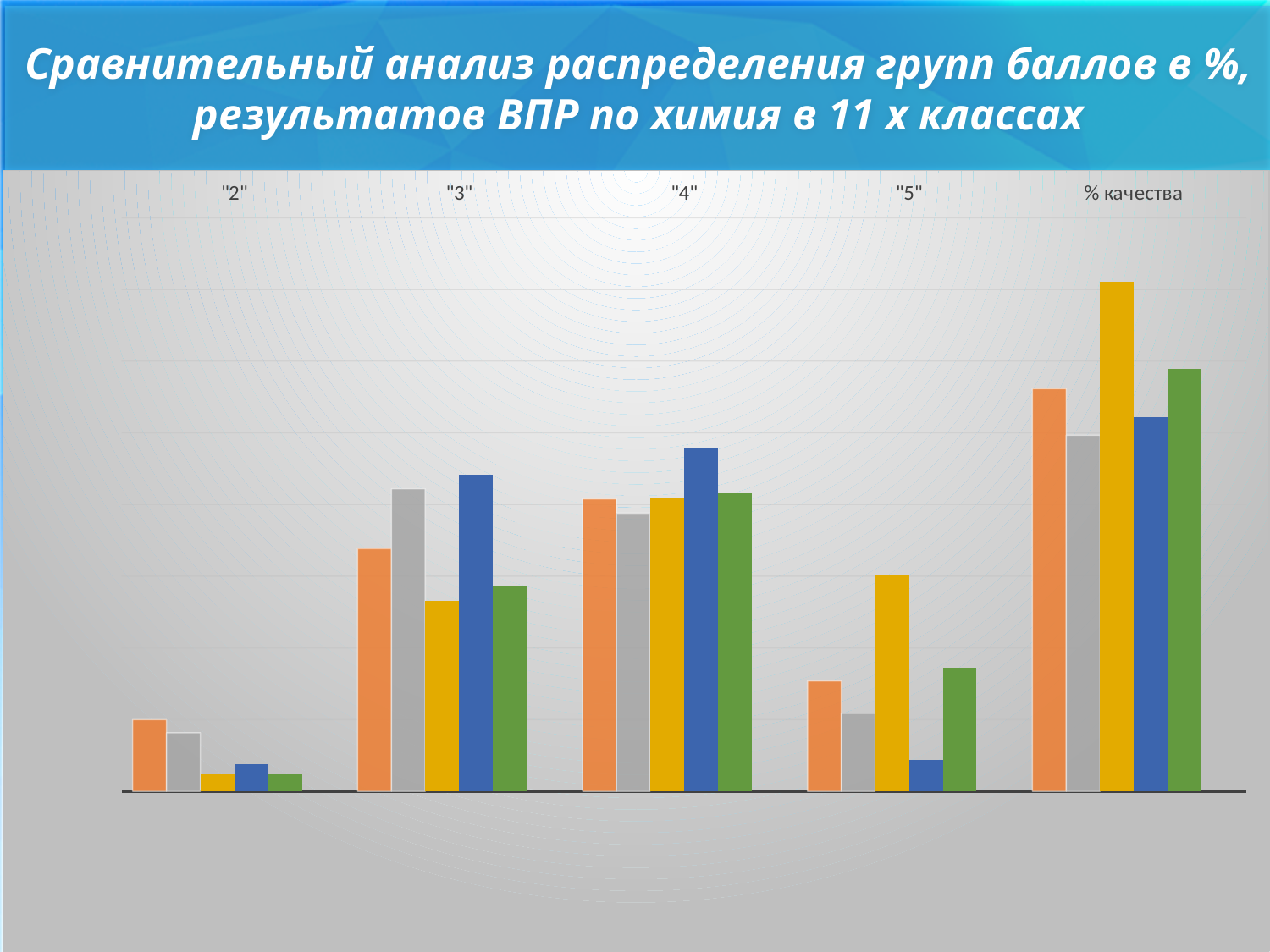
What is the label of the first category on the x axis? "2" What is the label of the last category on the x axis? % качества How many bars are plotted for each category on the chart? 5 Which category has taller bars overall: "3" or "2"? "3" What kind of chart is shown on the slide? bar chart Are the bars for category "4" taller or shorter than the bars for category "2"? taller Which category on the x axis has the lowest bars overall in the chart? "2" Which category on the x axis contains the tallest bar in the chart? % качества How many categories are shown along the x axis of the chart? 5